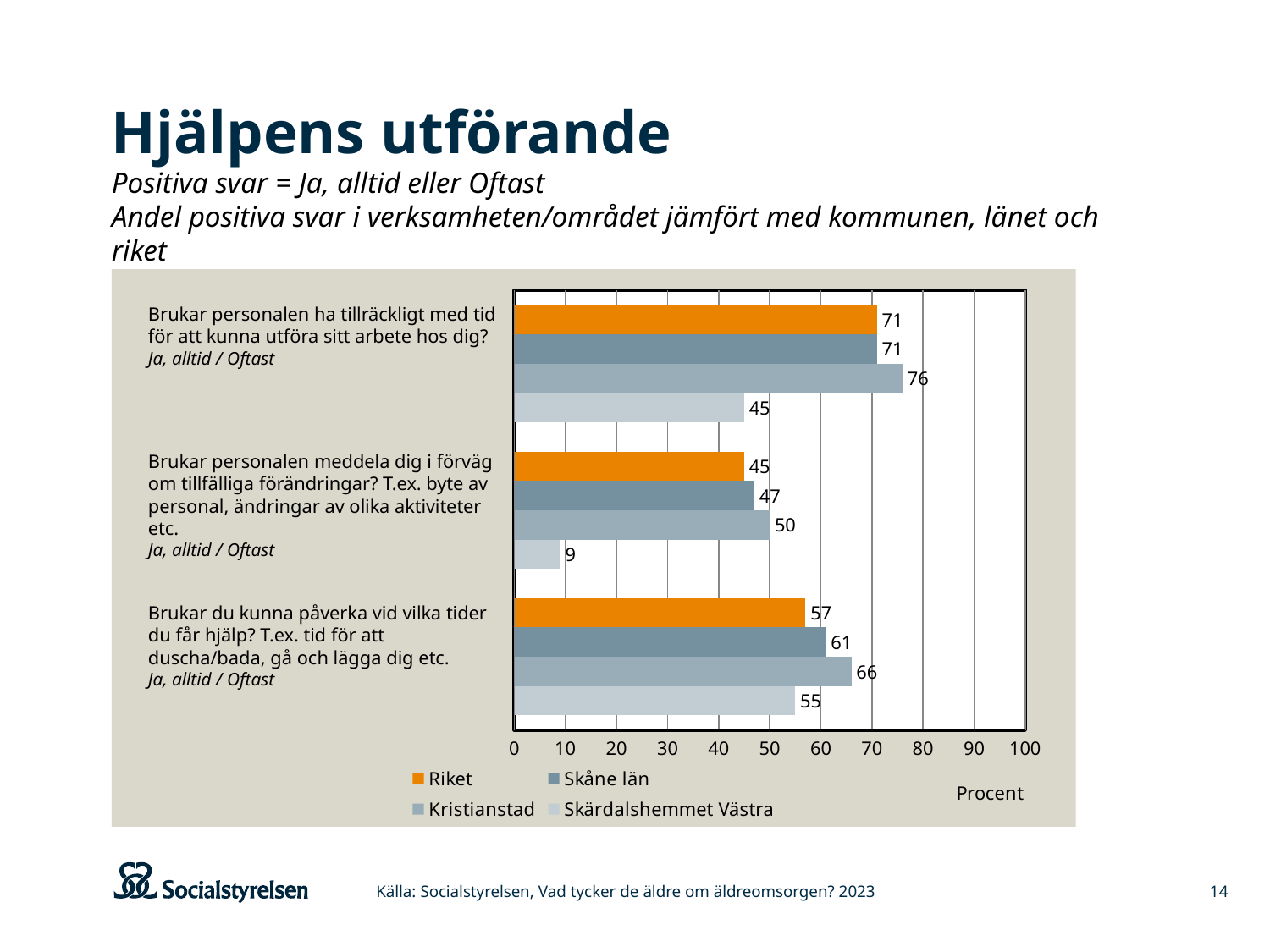
How many question categories are plotted on the chart? 3 What is the value for Skärdalshemmet Västra on the question 'Brukar personalen meddela dig i förväg om tillfälliga förändringar?' 9 How many series does the legend list? 4 On the question 'Brukar du kunna påverka vid vilka tider du får hjälp?', which is larger: Riket or Skärdalshemmet Västra? Riket What is the value for Skåne län on the question 'Brukar du kunna påverka vid vilka tider du får hjälp?' 61 What is the difference between Kristianstad and Skärdalshemmet Västra on the question 'Brukar personalen ha tillräckligt med tid för att kunna utföra sitt arbete hos dig?' 31 Is the value for Skärdalshemmet Västra on the question 'Brukar personalen ha tillräckligt med tid för att kunna utföra sitt arbete hos dig?' greater or less than 50? less Which series has the highest value on the question 'Brukar du kunna påverka vid vilka tider du får hjälp?' Kristianstad What unit is shown on the x axis of the chart? Procent What is the value for Kristianstad on the question 'Brukar personalen ha tillräckligt med tid för att kunna utföra sitt arbete hos dig?' 76 Which series has the lowest value on the question 'Brukar personalen meddela dig i förväg om tillfälliga förändringar?' Skärdalshemmet Västra What kind of chart is shown on the slide? Bar chart